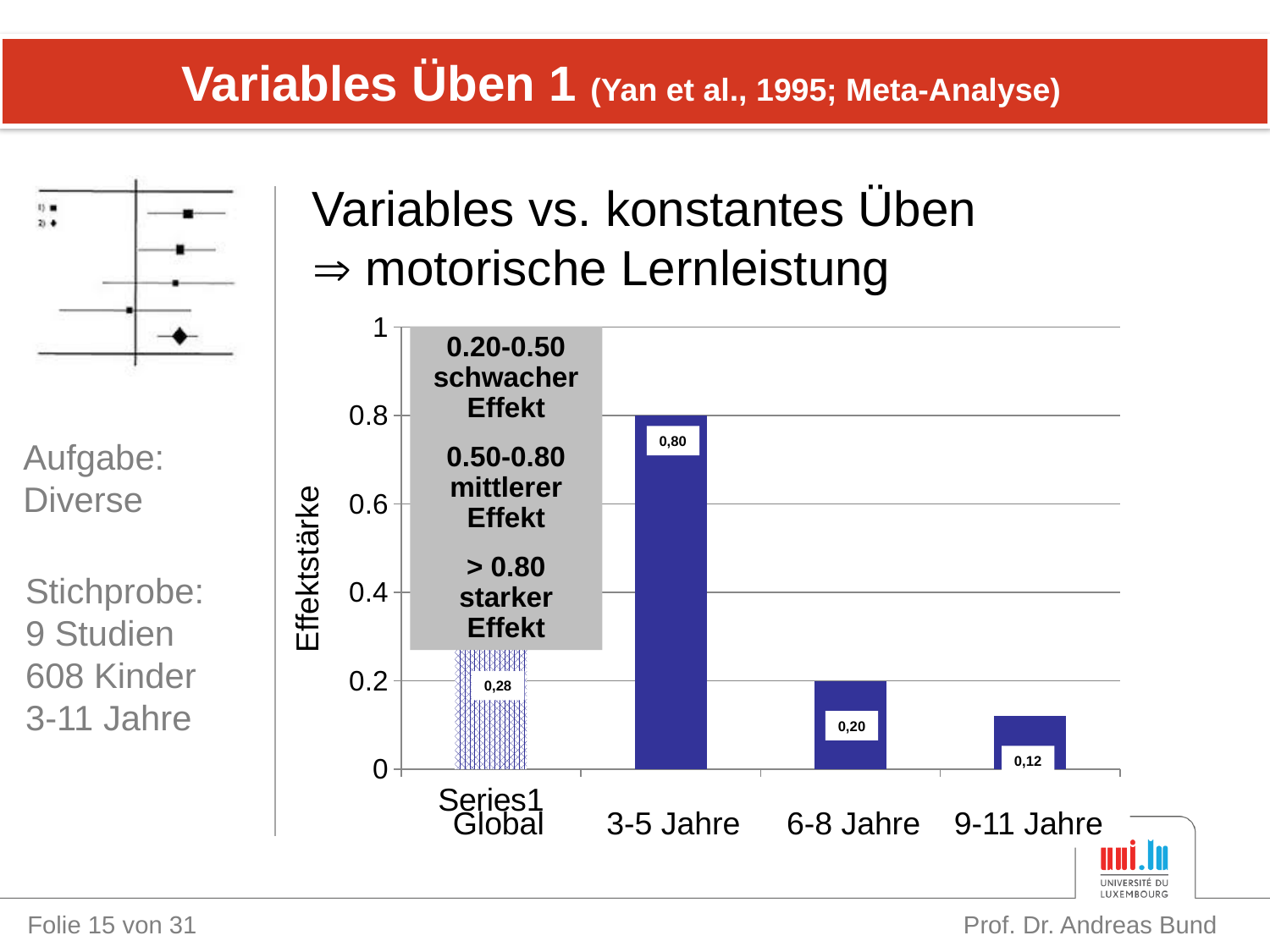
Which category has the lowest Effektstärke? 9-11 Jahre What is the Effektstärke value for the Global bar? 0,28 What is the Effektstärke value for 3-5 Jahre? 0,80 What kind of chart is shown on the slide? bar chart Which is larger, the Effektstärke for Global or for 6-8 Jahre? Global What is the difference between the Effektstärke for 3-5 Jahre and 6-8 Jahre? 0,60 How many categories are shown on the x axis of the chart? 4 Is the value for 3-5 Jahre greater or less than 0.6? greater Which category has the highest Effektstärke? 3-5 Jahre What is the Effektstärke value for 6-8 Jahre? 0,20 What is the label of the y axis of the chart? Effektstärke What is the Effektstärke value for 9-11 Jahre? 0,12